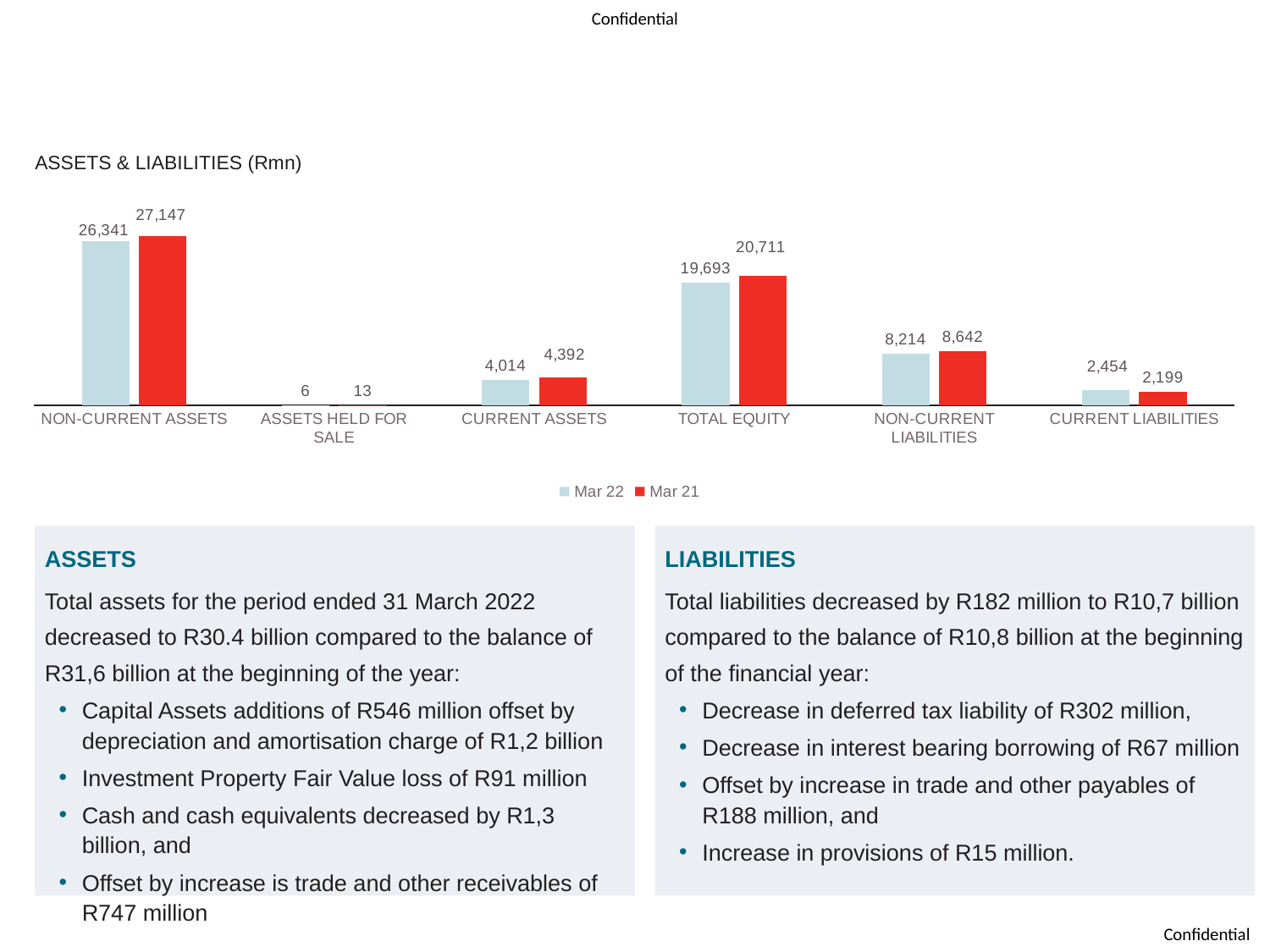
Which category has the lowest Mar 22 value? ASSETS HELD FOR SALE What is the difference between the Mar 21 and Mar 22 values for NON-CURRENT LIABILITIES? 428 Which category has the highest Mar 21 value? NON-CURRENT ASSETS What is the Mar 21 value for CURRENT LIABILITIES? 2,199 How many categories are shown on the x axis? 6 How many series does the legend list? 2 What is the title of the chart? ASSETS & LIABILITIES (Rmn) What is the Mar 22 value for NON-CURRENT ASSETS? 26,341 What kind of chart is shown on the slide? Bar chart What is the Mar 22 value for TOTAL EQUITY? 19,693 What is the Mar 21 value for CURRENT ASSETS? 4,392 For CURRENT LIABILITIES, which is larger: the Mar 22 value or the Mar 21 value? Mar 22